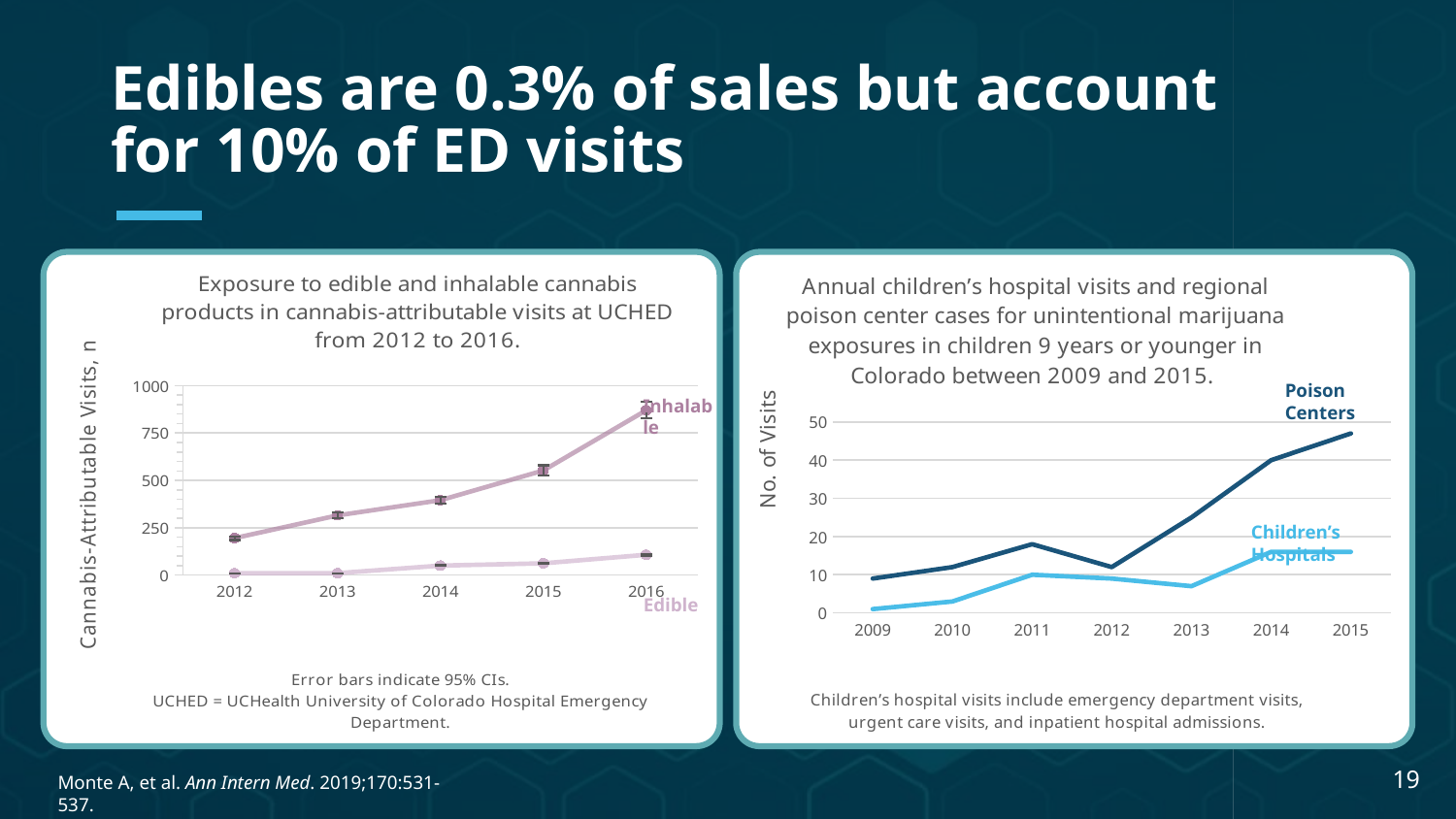
In the right chart (children's hospital visits and poison center cases in Colorado), is the Children's Hospitals value for 2009 greater or less than 10? less In the left chart (UCHED cannabis-attributable visits), how many series are plotted? 2 What kind of chart is the left chart, 'Exposure to edible and inhalable cannabis products in cannabis-attributable visits at UCHED from 2012 to 2016'? Line chart In the left chart (UCHED cannabis-attributable visits), which series has the larger value in 2014, Inhalable or Edible? Inhalable In the left chart (UCHED cannabis-attributable visits), in which year is the Inhalable series highest? 2016 In the left chart (UCHED cannabis-attributable visits), is the Inhalable value for 2016 greater or less than 750? greater In the left chart (UCHED cannabis-attributable visits), how many years are shown on the x axis? 5 In the left chart (UCHED cannabis-attributable visits), do the Inhalable values rise or fall from 2012 to 2016? Rise In the right chart (children's hospital visits and poison center cases in Colorado), how many years are shown on the x axis? 7 In the right chart (children's hospital visits and poison center cases in Colorado), in which year is the Poison Centers series highest? 2015 In the left chart (UCHED cannabis-attributable visits), is the Inhalable value for 2012 greater or less than 250? less